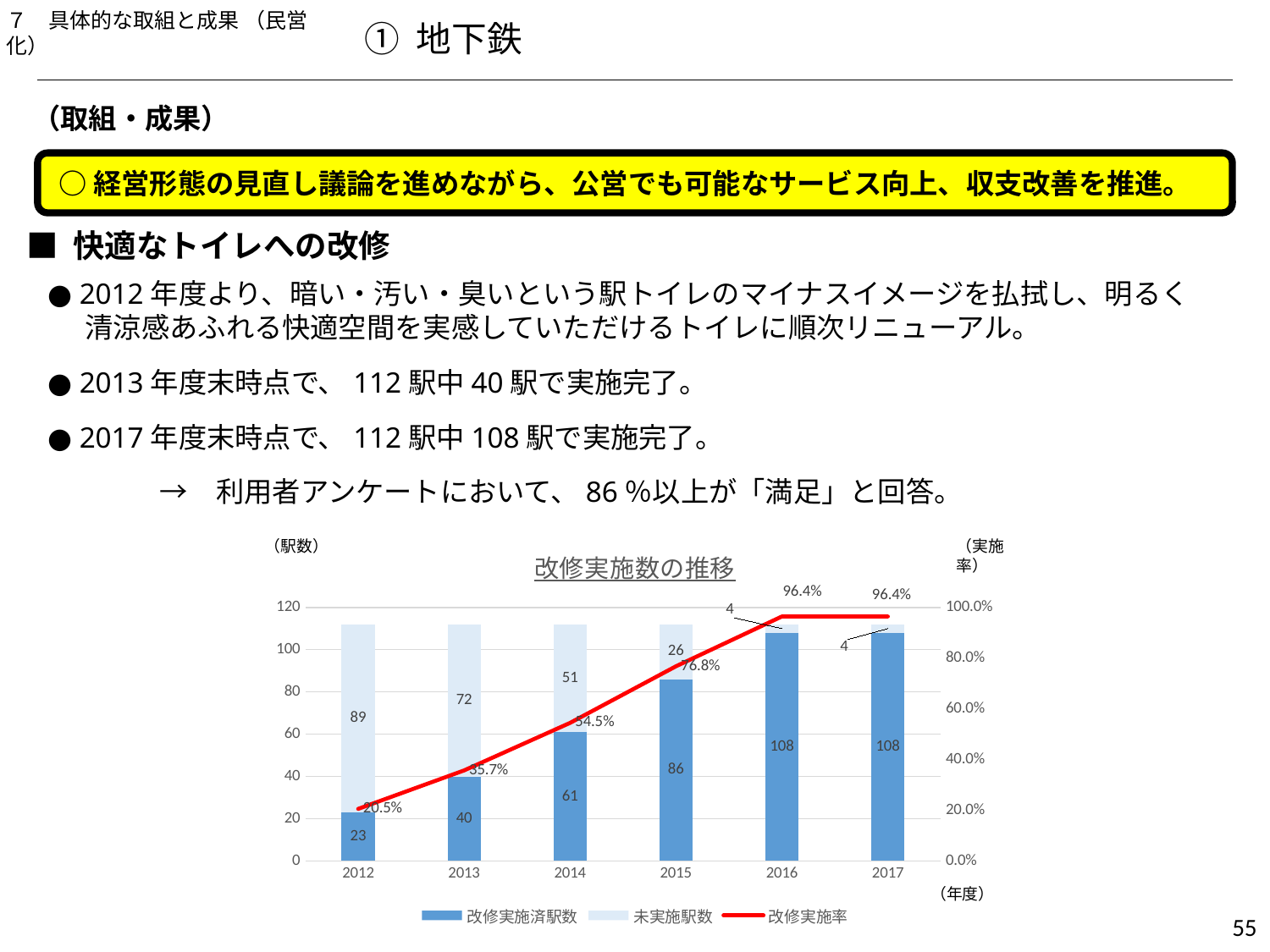
「改修実施数の推移」のグラフで、2014年の改修実施済駅数と未実施駅数ではどちらが多いですか？ 改修実施済駅数 「改修実施数の推移」のグラフには、何年度分のデータが表示されていますか？ 6 「改修実施数の推移」のグラフで、2016年と2013年の改修実施済駅数の差はいくつですか？ 68 「改修実施数の推移」のグラフで、未実施駅数が最も多い年度はどれですか？ 2012 「改修実施数の推移」のグラフで、2015年の積み上げ棒の合計（改修実施済駅数＋未実施駅数）はいくつですか？ 112 「改修実施数の推移」のグラフで、改修実施率を示す線は何色ですか？ 赤 「改修実施数の推移」のグラフで、2014年の改修実施済駅数はいくつですか？ 61 「改修実施数の推移」のグラフで、改修実施済駅数が最も少ない年度はどれですか？ 2012 「改修実施数の推移」のグラフの凡例には、いくつの系列が示されていますか？ 3 「改修実施数の推移」のグラフで、2013年の未実施駅数はいくつですか？ 72 「改修実施数の推移」のグラフで、2015年の改修実施率は何％ですか？ 76.8% 「改修実施数の推移」のグラフで、改修実施率は2012年から2016年にかけて上昇していますか、下降していますか？ 上昇